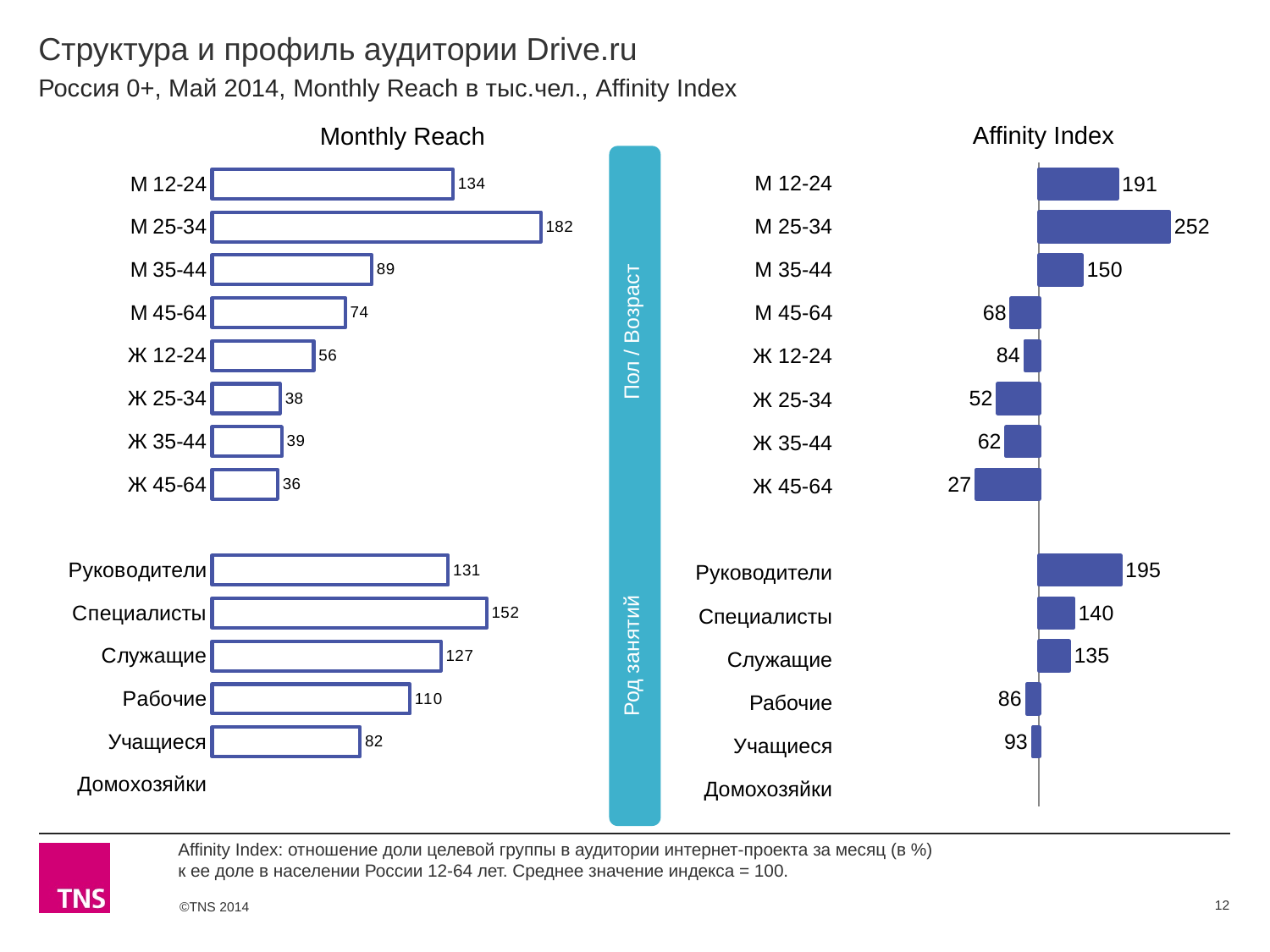
In the Monthly Reach chart, which is larger: Руководители or Служащие? Руководители In the Monthly Reach chart, which category has the highest value? М 25-34 In the Affinity Index chart, what is the value for Учащиеся? 93 What kind of chart is the Monthly Reach chart? bar chart In the Monthly Reach chart, what is the difference between Специалисты and Рабочие? 42 In the Monthly Reach chart, how many categories in the Пол / Возраст group have a bar with a value? 8 In the Monthly Reach chart, what is the value for Ж 45-64? 36 In the Affinity Index chart, which is larger: М 12-24 or М 35-44? М 12-24 In the Affinity Index chart, what is the value for Руководители? 195 In the Affinity Index chart, what is the difference between М 25-34 and Ж 25-34? 200 In the Affinity Index chart, which category has the lowest value? Ж 45-64 In the Monthly Reach chart, what is the value for М 25-34? 182